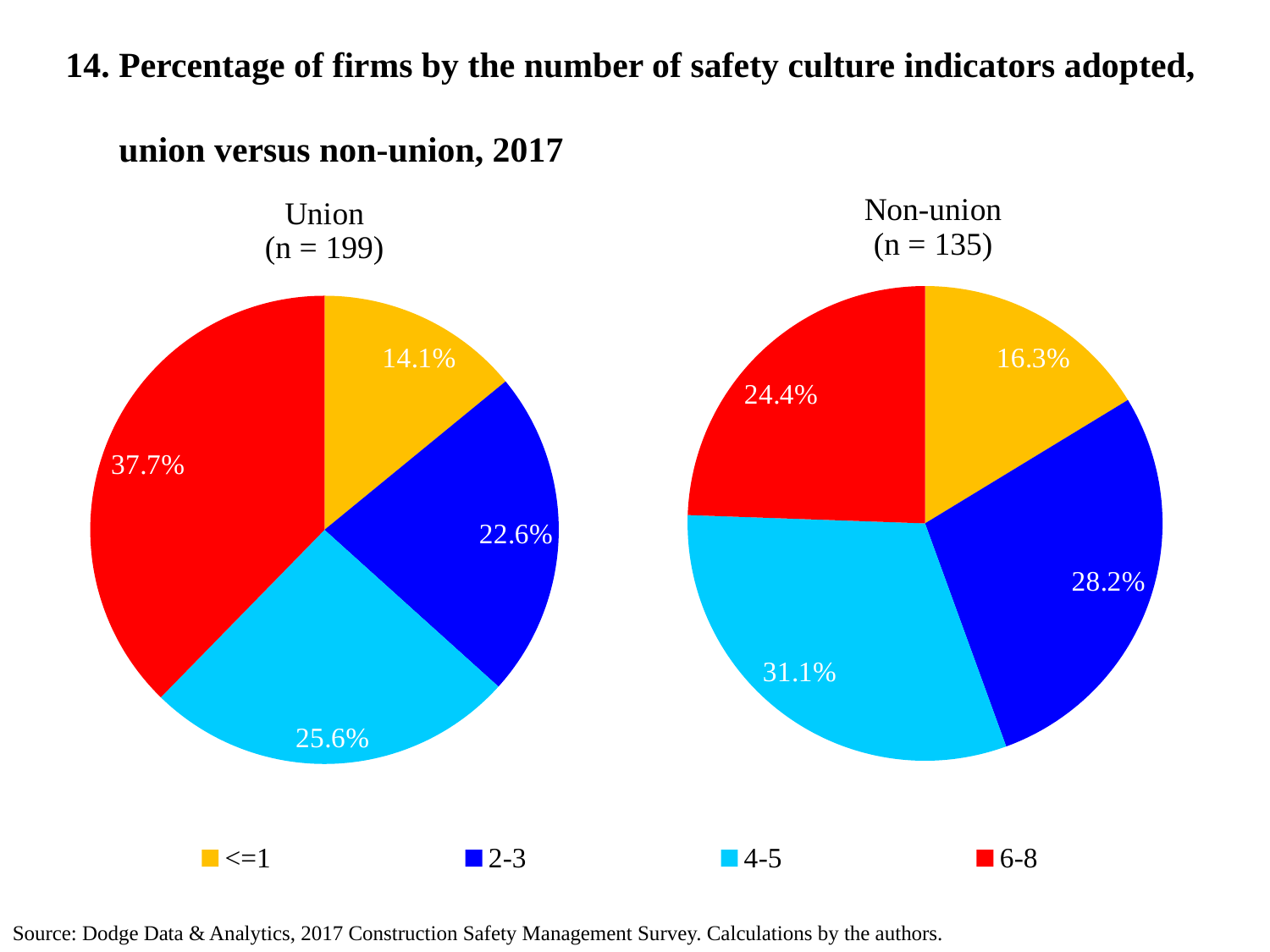
In the Union pie chart, what percentage of firms adopted <=1 safety culture indicators? 14.1% What is the sample size (n) for the Union pie chart? 199 What is the difference between the Union and Non-union percentages for firms adopting 6-8 indicators? 13.3 percentage points In the Non-union pie chart, what percentage of firms adopted 4-5 safety culture indicators? 31.1% Which is larger: the Union share for 2-3 indicators or the Non-union share for 2-3 indicators? Non-union What type of chart is used on this slide? Pie chart In the Union pie chart, which category has the largest share? 6-8 How many categories does each pie chart show? 4 In the Non-union pie chart, which category has the smallest share? <=1 In the Non-union pie chart, what percentage of firms adopted 2-3 safety culture indicators? 28.2% In the Union pie chart, what percentage of firms adopted 6-8 safety culture indicators? 37.7% In the Non-union pie chart, which category has the largest share? 4-5